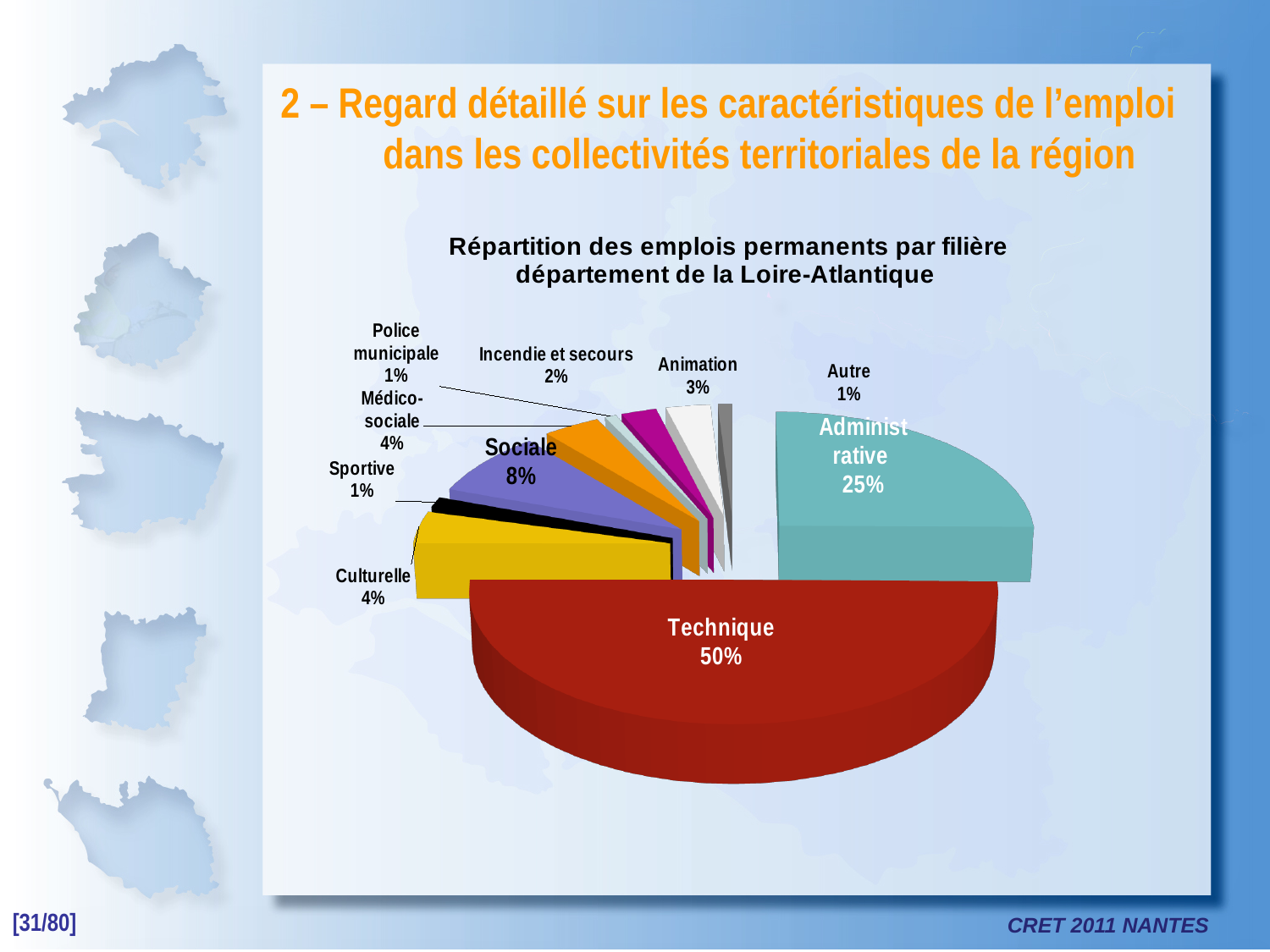
What share of permanent jobs does the Technique filière hold? 50% What type of chart is shown on the slide? Pie chart Which is larger, the Animation slice or the Culturelle slice? Culturelle What is the difference in percentage points between Technique and Administrative? 25 Which filière has the largest share of the pie? Technique Which filières are shown with a share of 1%? Police municipale, Sportive, Autre Which département does the chart title say the data is for? Loire-Atlantique What is the difference between the Sociale share and the Médico-sociale share? 4% How many categories are labelled on the pie chart? 10 What percentage is shown for the Administrative slice? 25% What is the value for the Sociale slice? 8% What percentage is shown for Incendie et secours? 2%